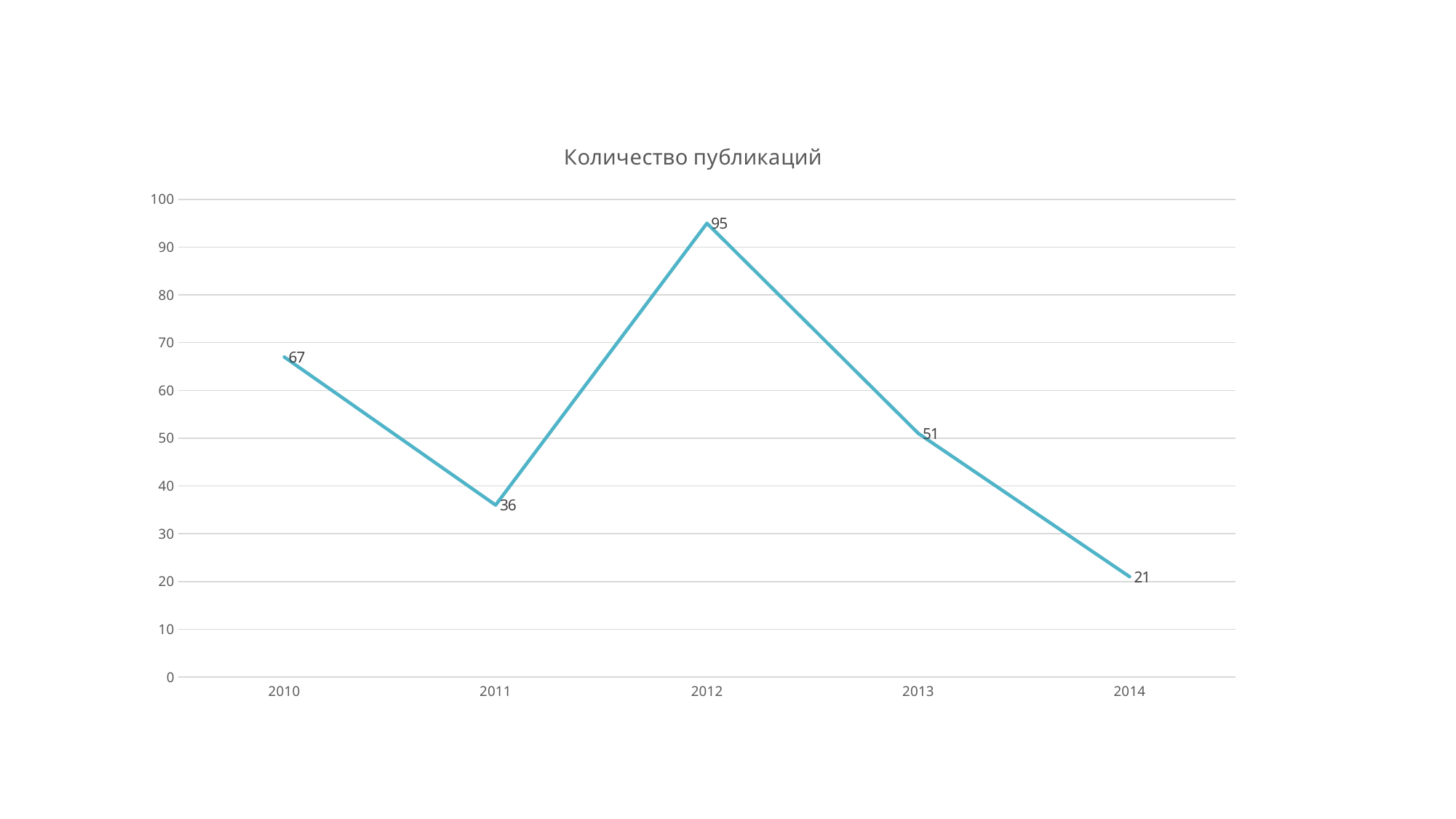
What is the value for 2014? 21 Which is larger, the value for 2010 or the value for 2013? 2010 What is the difference between the values for 2013 and 2014? 30 Is the value for 2011 greater or less than 40? less What kind of chart is shown? line chart Which year has the lowest value? 2014 What is the value for 2010? 67 What is the title of the chart? Количество публикаций Which year has the highest value? 2012 How many years are plotted on the x axis? 5 What is the value for 2012? 95 What is the difference between the values for 2012 and 2011? 59